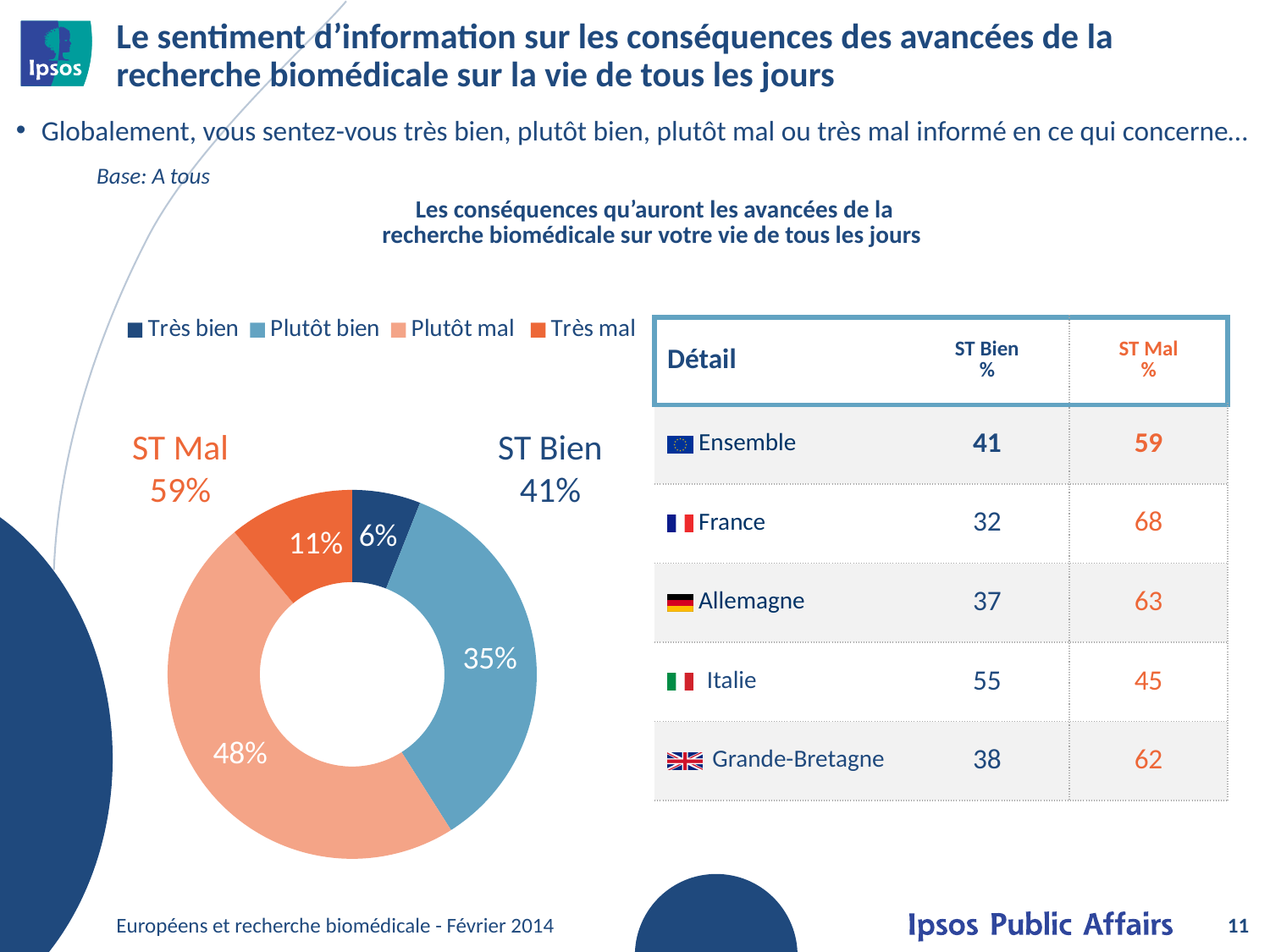
What percentage of respondents answered "Plutôt mal"? 48% What is the combined "ST Bien" percentage shown next to the donut chart? 41% Which is larger, the share for "Très mal" or the share for "Très bien"? Très mal What is the combined "ST Mal" percentage shown next to the donut chart? 59% What percentage of respondents answered "Plutôt bien"? 35% How many response categories does the legend of the donut chart list? 4 What percentage of respondents answered "Très mal"? 11% What kind of chart is shown on the slide? Donut (pie) chart What percentage of respondents answered "Très bien"? 6% Which response category has the smallest slice of the donut chart? Très bien Which response category has the largest slice of the donut chart? Plutôt mal What is the difference in percentage points between "Plutôt mal" and "Plutôt bien"? 13